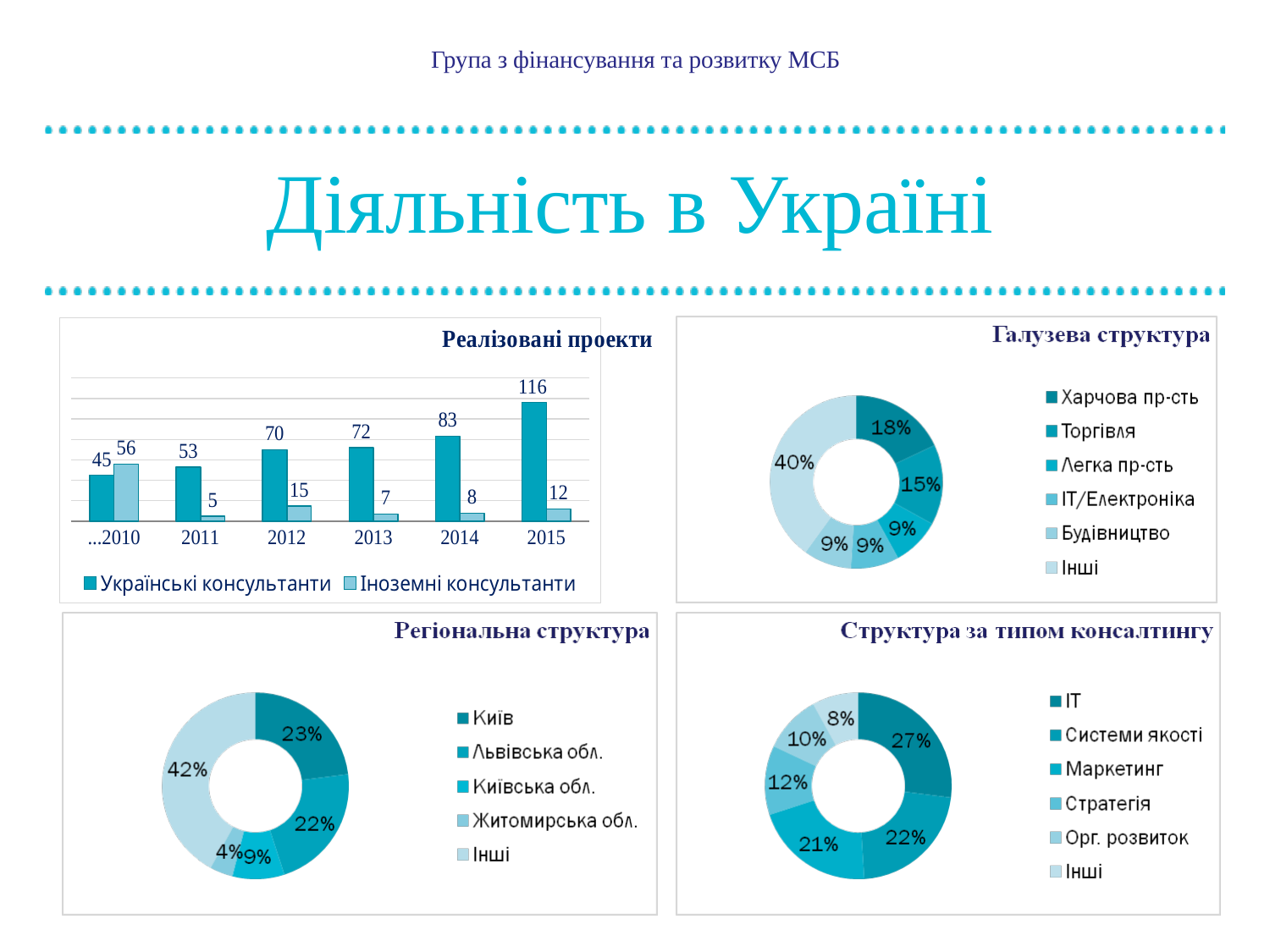
In the 'Структура за типом консалтингу' chart, which is larger: ІТ or Маркетинг? ІТ In the 'Реалізовані проекти' chart, which year has the highest value for Українські консультанти? 2015 In the 'Реалізовані проекти' chart, what is the value for Українські консультанти in 2015? 116 In the 'Галузева структура' chart, which category has the largest share? Інші In the 'Реалізовані проекти' chart, how many series does the legend list? 2 What kind of chart is 'Реалізовані проекти'? Bar chart In the 'Галузева структура' chart, what share does Харчова пр-сть have? 18% In the 'Структура за типом консалтингу' chart, how many categories does the legend list? 6 In the 'Реалізовані проекти' chart, what is the difference between Українські консультанти and Іноземні консультанти in 2014? 75 In the 'Реалізовані проекти' chart, do the values for Українські консультанти rise or fall from ...2010 to 2015? Rise In the 'Регіональна структура' chart, what share does Житомирська обл. have? 4% In the 'Реалізовані проекти' chart, what is the value for Іноземні консультанти in 2012? 15